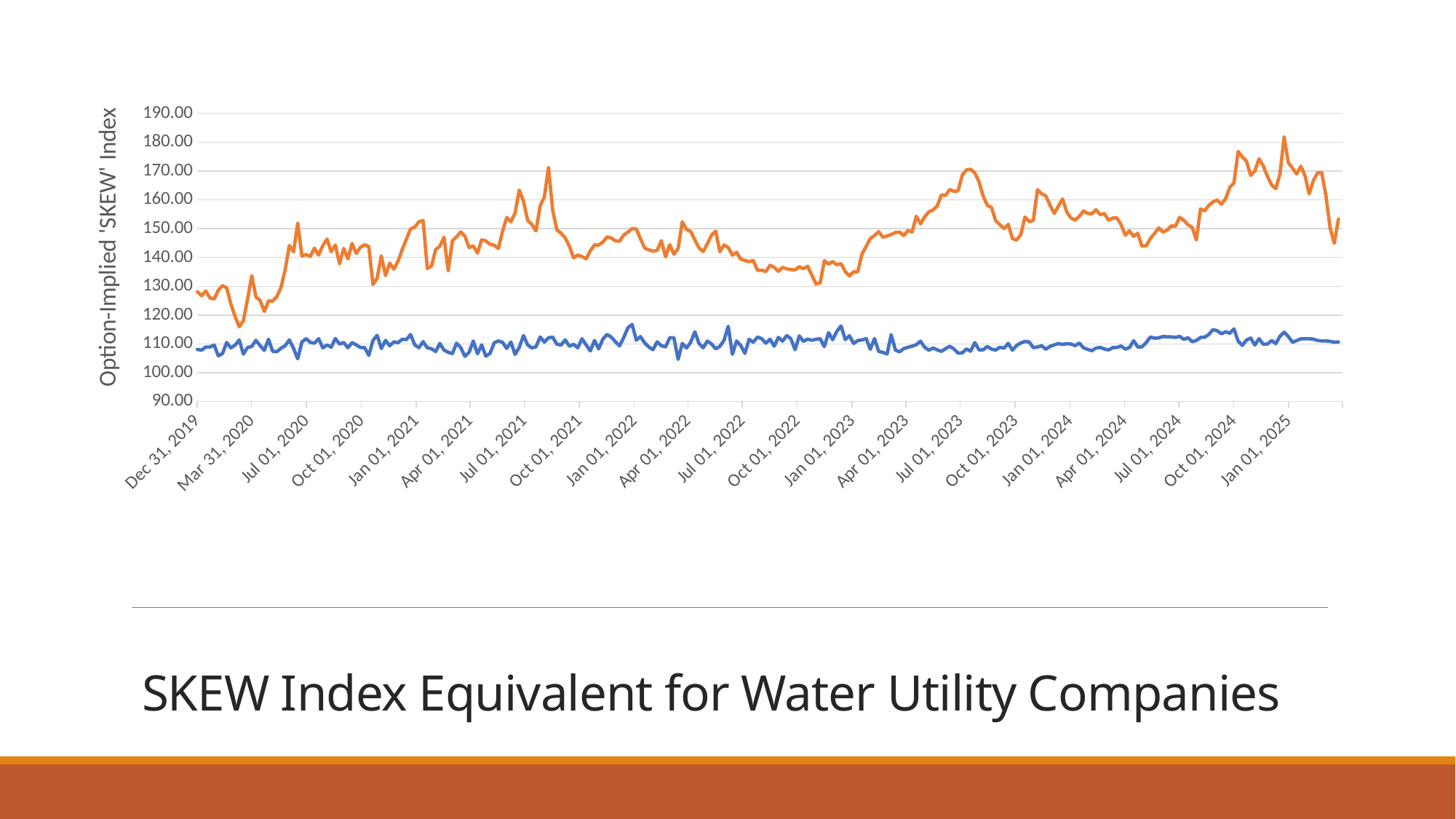
Is the value of the orange line at Jul 01, 2023 greater or less than 160.00? greater Is the value of the orange line at Jan 01, 2023 greater or less than 140.00? less Near which x-axis date does the orange line reach its lowest value? Mar 31, 2020 Overall, does the orange line rise or fall from Dec 31, 2019 to Jan 01, 2025? rise Does the blue line ever rise above 120.00 on the chart? no What is the title text shown below the chart? SKEW Index Equivalent for Water Utility Companies Which line is higher across the whole chart, the orange line or the blue line? orange How many lines are plotted on the chart? 2 What is the label on the vertical axis of the chart? Option-Implied 'SKEW' Index What kind of chart is shown on the slide? line chart